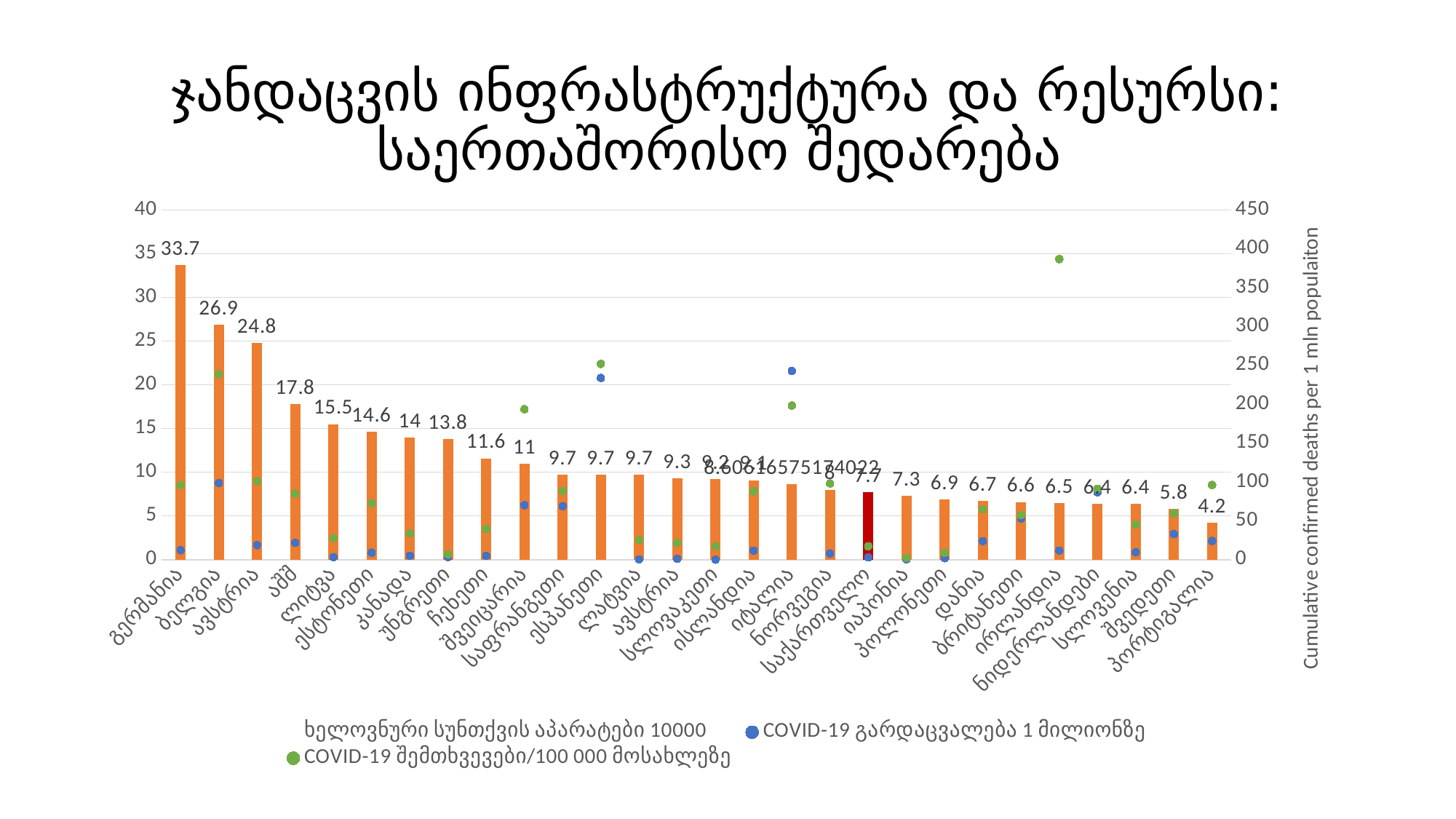
How many series does the legend list? 3 What is the value of the bar for საქართველო (the red bar)? 7.7 Which has a larger bar value, ავსტრია (third bar) or აშშ? ავსტრია Do the bar values rise or fall from left to right along the x axis? fall How many countries are shown on the x axis? 28 Is the green point for ირლანდია on the right axis greater or less than 350? greater What is the value of the bar for აშშ? 17.8 What kind of chart is used for the ventilator values? bar chart What is the value of the bar for გერმანია? 33.7 Which country has the highest bar value? გერმანია Which country has the lowest bar value? პორტიგალია What is the difference between the bar values for გერმანია and ბელგია? 6.8